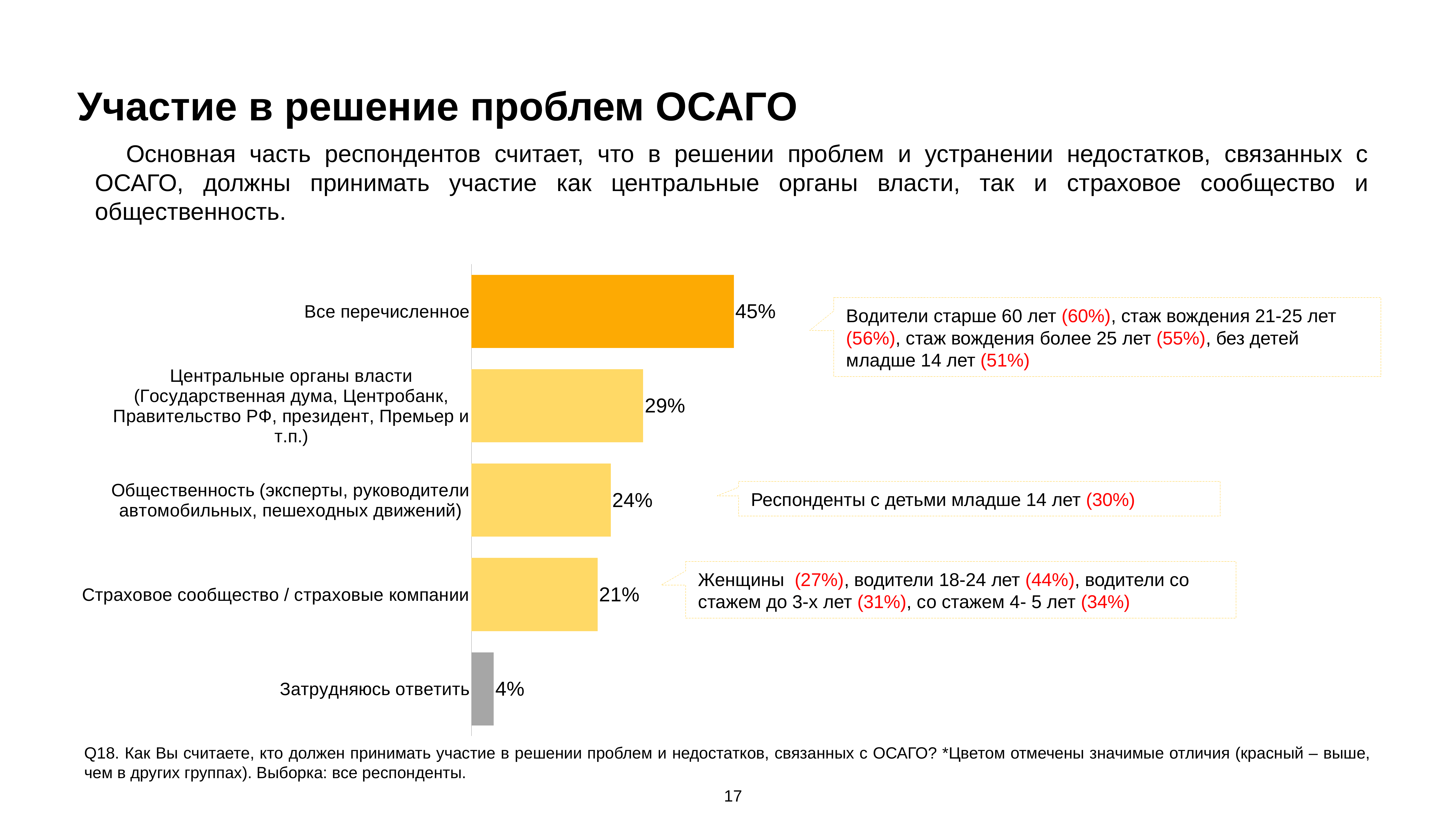
What is the value for "Страховое сообщество / страховые компании"? 21% Which is larger: "Центральные органы власти" or "Общественность"? Центральные органы власти What is the difference between "Все перечисленное" and "Центральные органы власти"? 16% What is the value for "Общественность (эксперты, руководители автомобильных, пешеходных движений)"? 24% Which bar is coloured grey? Затрудняюсь ответить What is the value for "Все перечисленное"? 45% What kind of chart is shown on the slide? Bar chart What is the value for "Затрудняюсь ответить"? 4% Which category has the highest value? Все перечисленное How many categories are shown in the chart? 5 What is the difference between "Общественность" and "Страховое сообщество / страховые компании"? 3% Which category has the lowest value? Затрудняюсь ответить